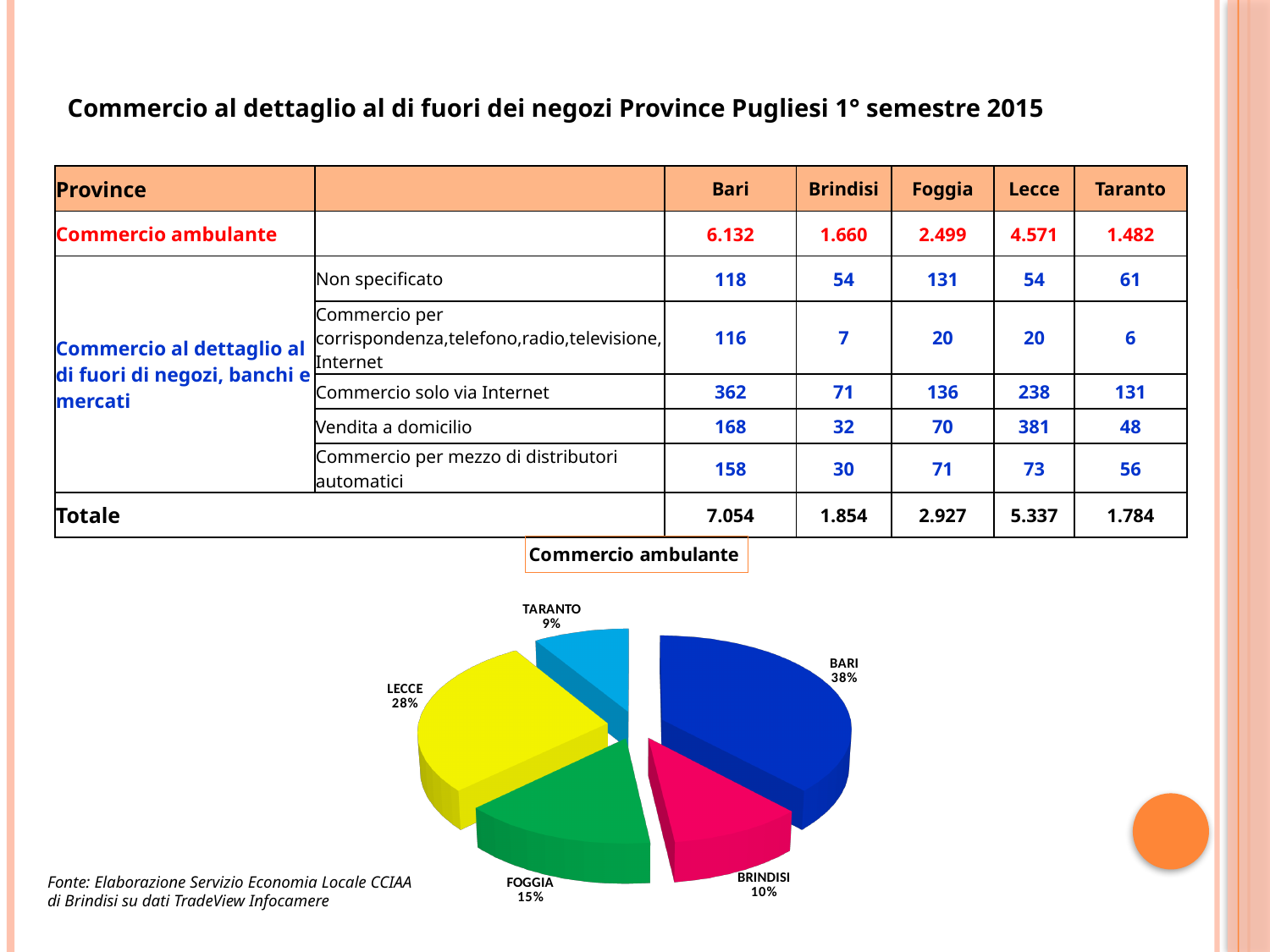
How many slices does the pie chart have? 5 What is the title of the pie chart? Commercio ambulante What share of the pie chart does Taranto have? 9% What share of the pie chart does Brindisi have? 10% Which slice is larger in the pie chart, Foggia or Brindisi? Foggia Which province has the smallest slice in the pie chart? Taranto What share of the pie chart does Lecce have? 28% What is the difference in percentage points between the Bari and Lecce slices? 10 What kind of chart is shown on the slide? pie chart Which province has the largest slice in the pie chart? Bari What share of the pie chart does Bari have? 38% What share of the pie chart does Foggia have? 15%